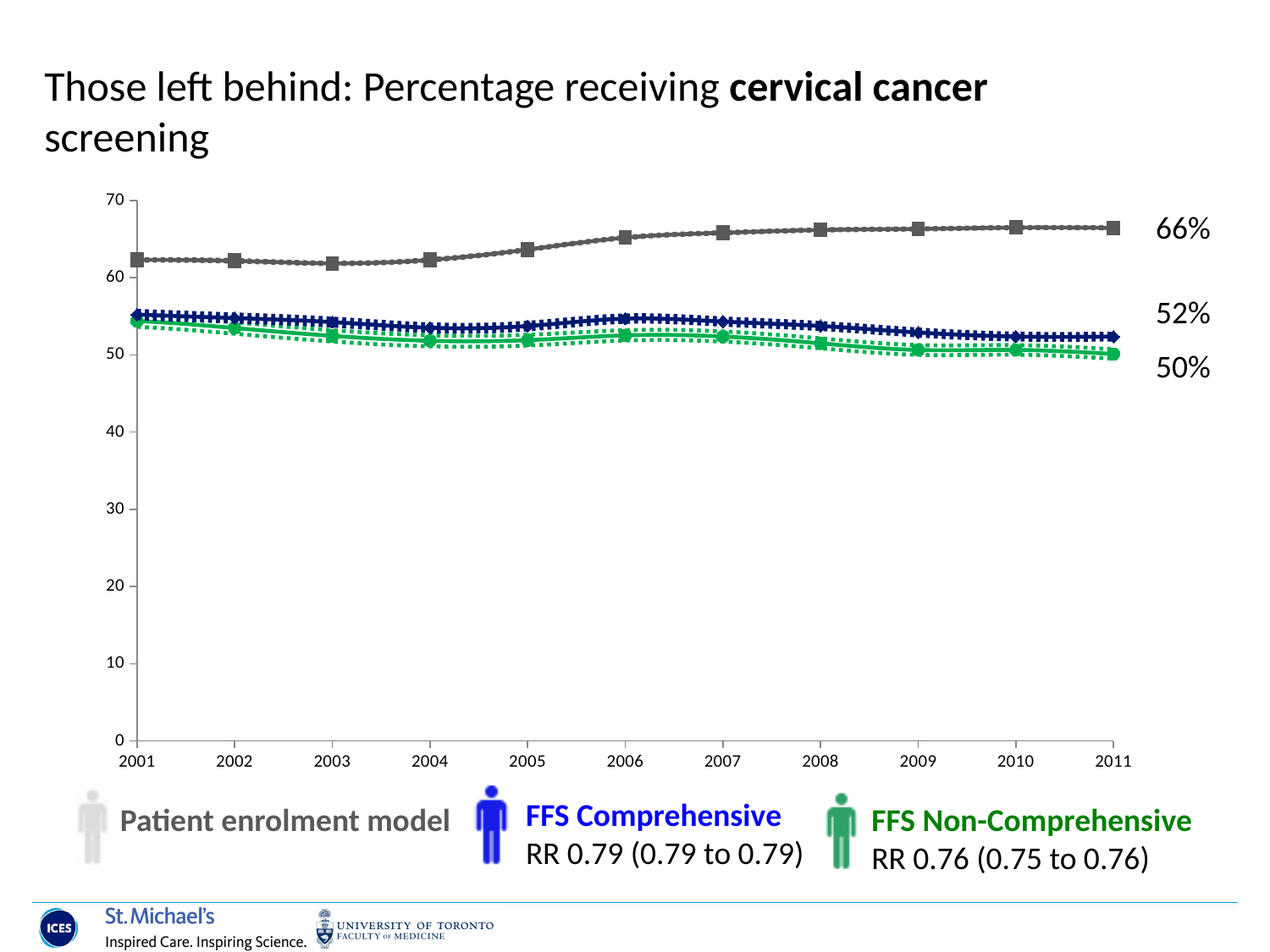
Is the value for the Patient enrolment model in 2001 greater or less than 60? greater What is the percentage receiving cervical cancer screening in 2011 for the Patient enrolment model? 66% Does the Patient enrolment model line rise or fall from 2001 to 2011? Rise What kind of chart is shown on the slide? Line chart What is the percentage receiving cervical cancer screening in 2011 for FFS Non-Comprehensive? 50% What is the difference between the 2011 values for the Patient enrolment model and FFS Non-Comprehensive? 16 percentage points Which series has the lowest value in 2011? FFS Non-Comprehensive Which series has the highest value in 2011? Patient enrolment model How many series does the chart's legend list? 3 What relative risk (RR) is shown for FFS Comprehensive? RR 0.79 (0.79 to 0.79) What is the percentage receiving cervical cancer screening in 2011 for FFS Comprehensive? 52% How many years are shown along the x axis of the chart? 11